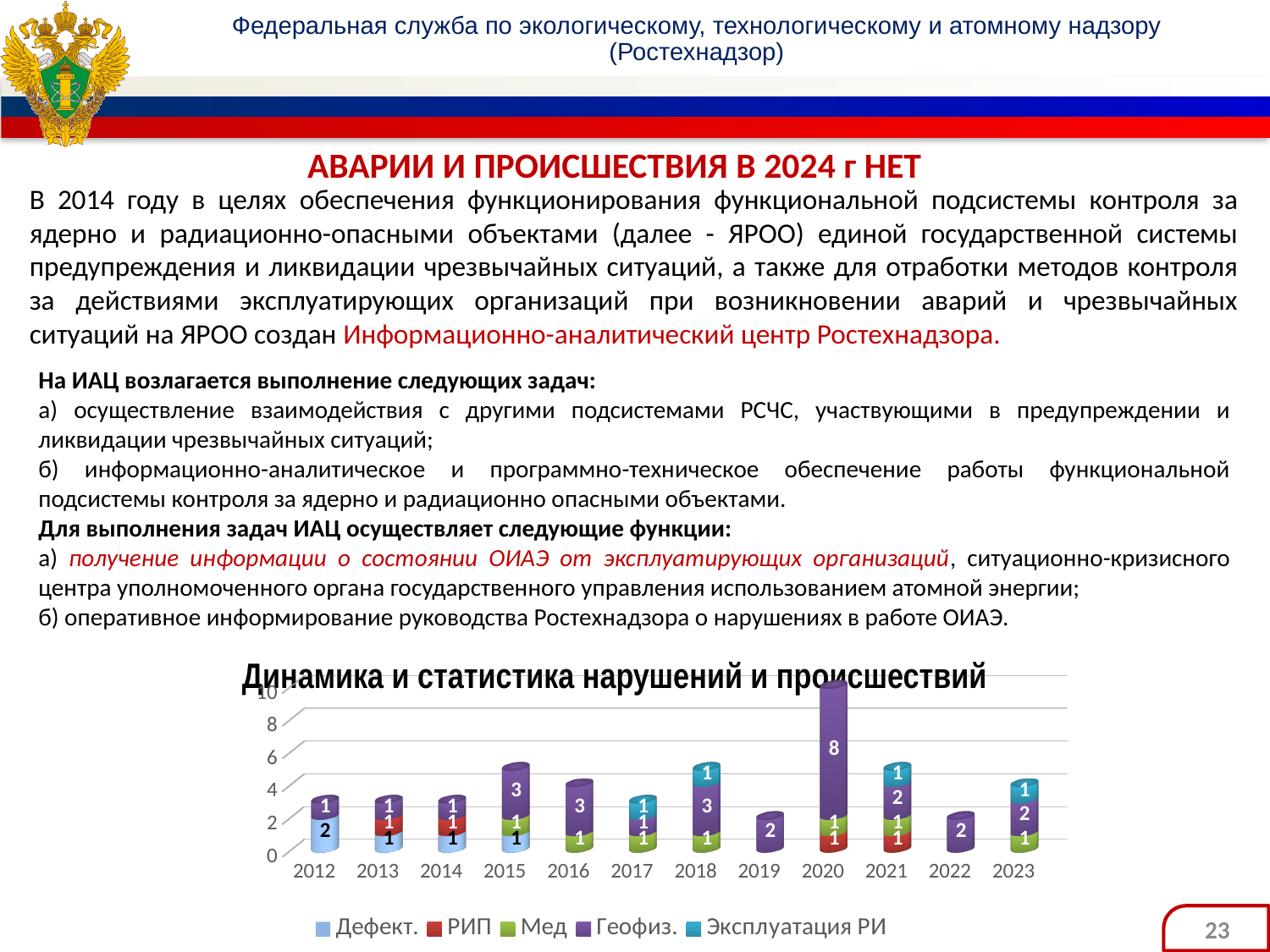
What is the value of the Дефект. series for 2012? 2 What is the value of the Геофиз. series for 2016? 3 What is the value of the Геофиз. series for 2020? 8 What is the value of the Геофиз. series for 2019? 2 How many years (categories) are shown on the x axis of the chart? 12 Which is larger: the Геофиз. value for 2020 or the Геофиз. value for 2022? 2020 How many series does the chart legend list? 5 Which series is listed last in the chart legend? Эксплуатация РИ What kind of chart is shown under the title "Динамика и статистика нарушений и происшествий"? Stacked bar chart What is the total of the stacked bar for 2020? 10 What is the difference between the Геофиз. value for 2020 and the Геофиз. value for 2018? 5 Which year has the tallest stacked bar in the chart? 2020